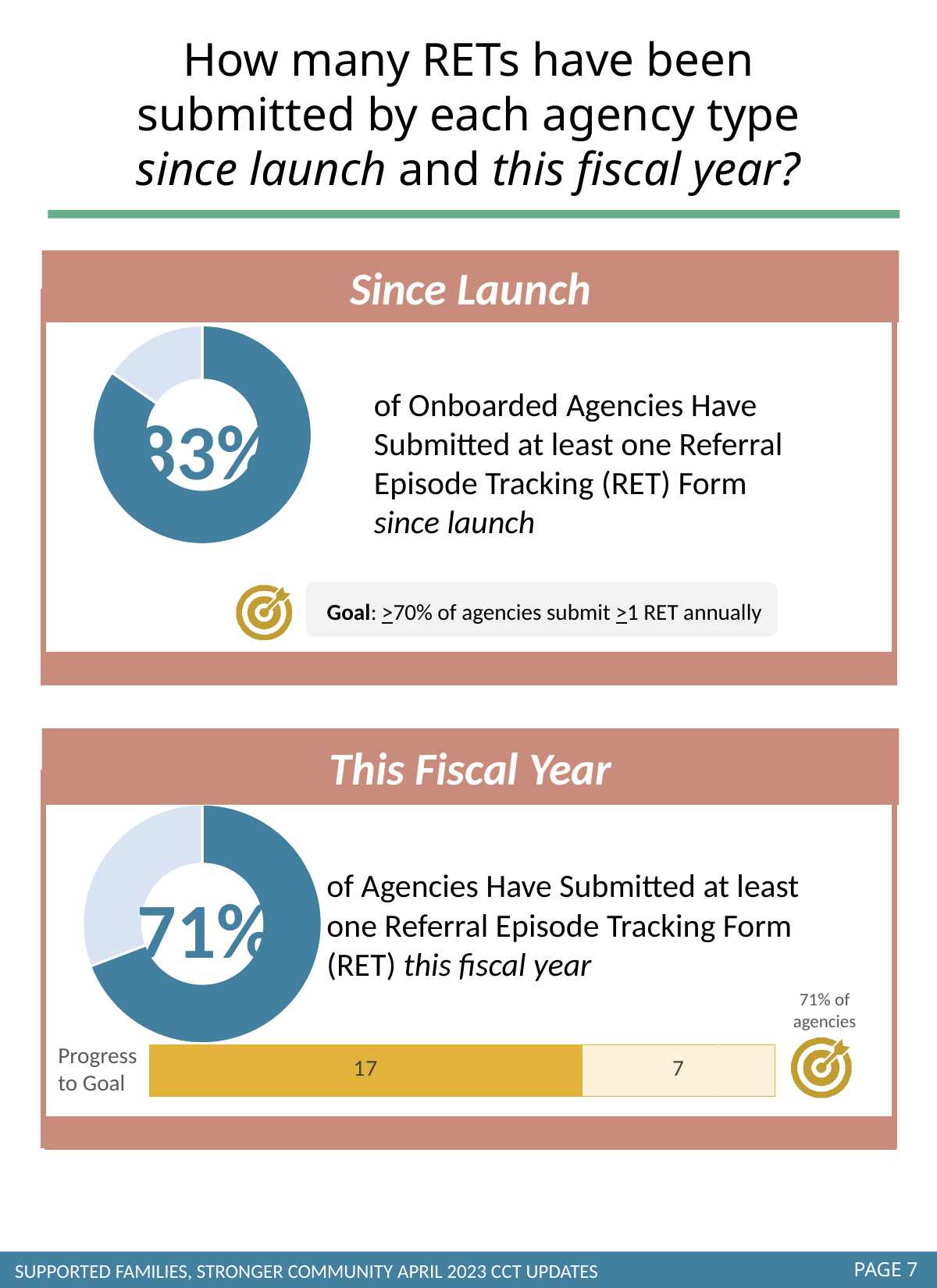
What goal is stated in the Since Launch section? ≥70% of agencies submit ≥1 RET annually What kind of chart is the Progress to Goal chart in the This Fiscal Year section? Stacked horizontal bar chart Which is larger: the Since Launch percentage or the This Fiscal Year percentage? Since Launch (83%) In the Progress to Goal bar chart, what is the value of the darker gold segment? 17 In the This Fiscal Year donut chart, what percentage of agencies have submitted at least one RET form? 71% In the Progress to Goal bar chart, what is the value of the lighter segment? 7 What kind of chart is used in the Since Launch section to show the 83% figure? Donut (pie) chart Is the This Fiscal Year percentage greater or less than 70%? greater In the Progress to Goal bar chart, what is the difference between the two segment values? 10 In the Since Launch donut chart, what percentage of onboarded agencies have submitted at least one RET form? 83% In the Progress to Goal bar chart, how many segments make up the bar? 2 In the Progress to Goal bar chart, what is the total of the two segments? 24